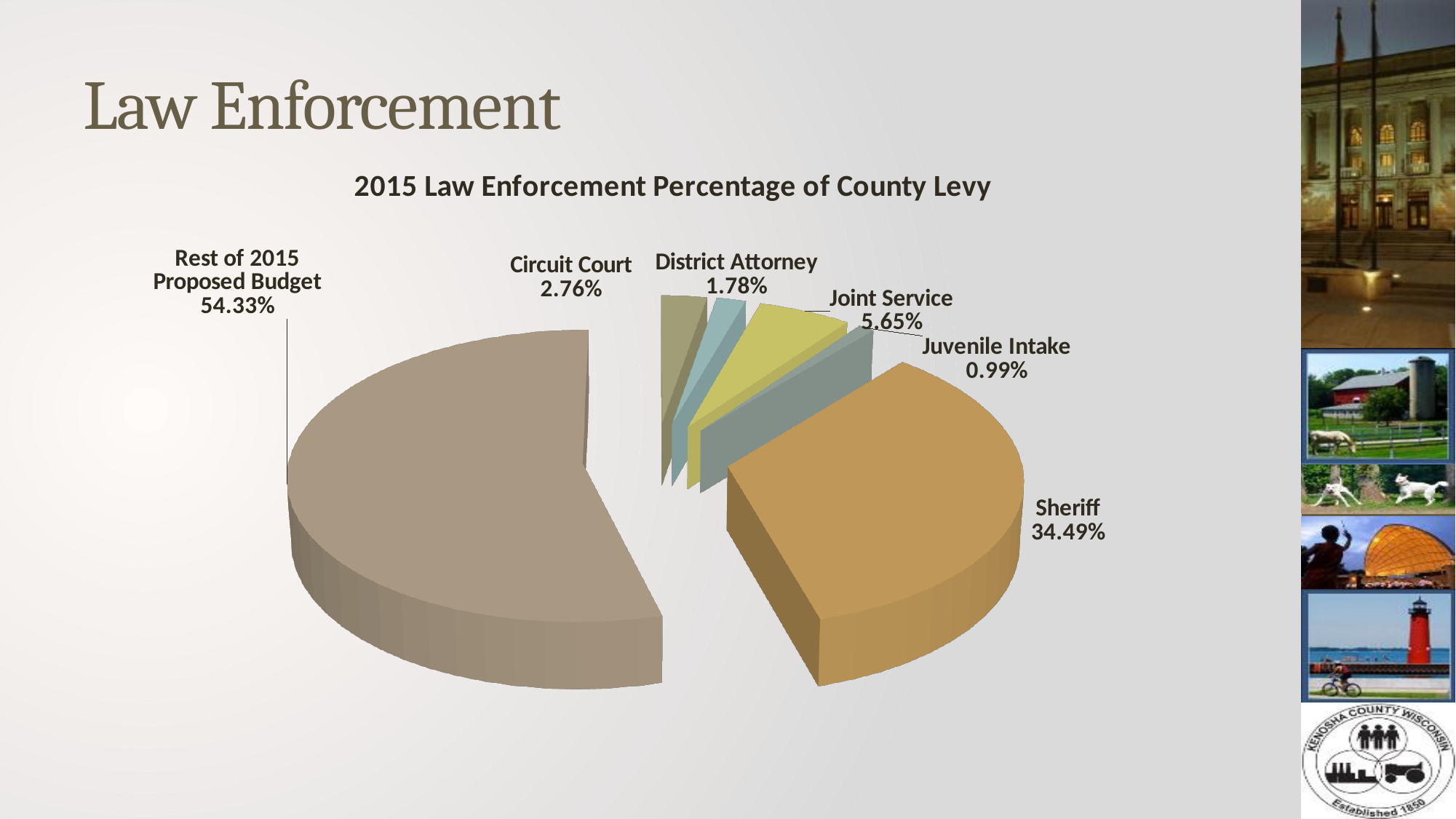
What is the value shown for Circuit Court? 2.76% Which slice of the pie is the smallest? Juvenile Intake What is the title of the chart? 2015 Law Enforcement Percentage of County Levy Which slice of the pie is the largest? Rest of 2015 Proposed Budget What kind of chart is shown on the slide? Pie chart What is the difference between the Rest of 2015 Proposed Budget share and the Sheriff share? 19.84% What percentage of the county levy does the Sheriff slice represent? 34.49% Which is larger, the Joint Service slice or the Circuit Court slice? Joint Service What is the value shown for Juvenile Intake? 0.99% How many slices does the pie chart have? 6 What is the value shown for District Attorney? 1.78% What is the value shown for Joint Service? 5.65%